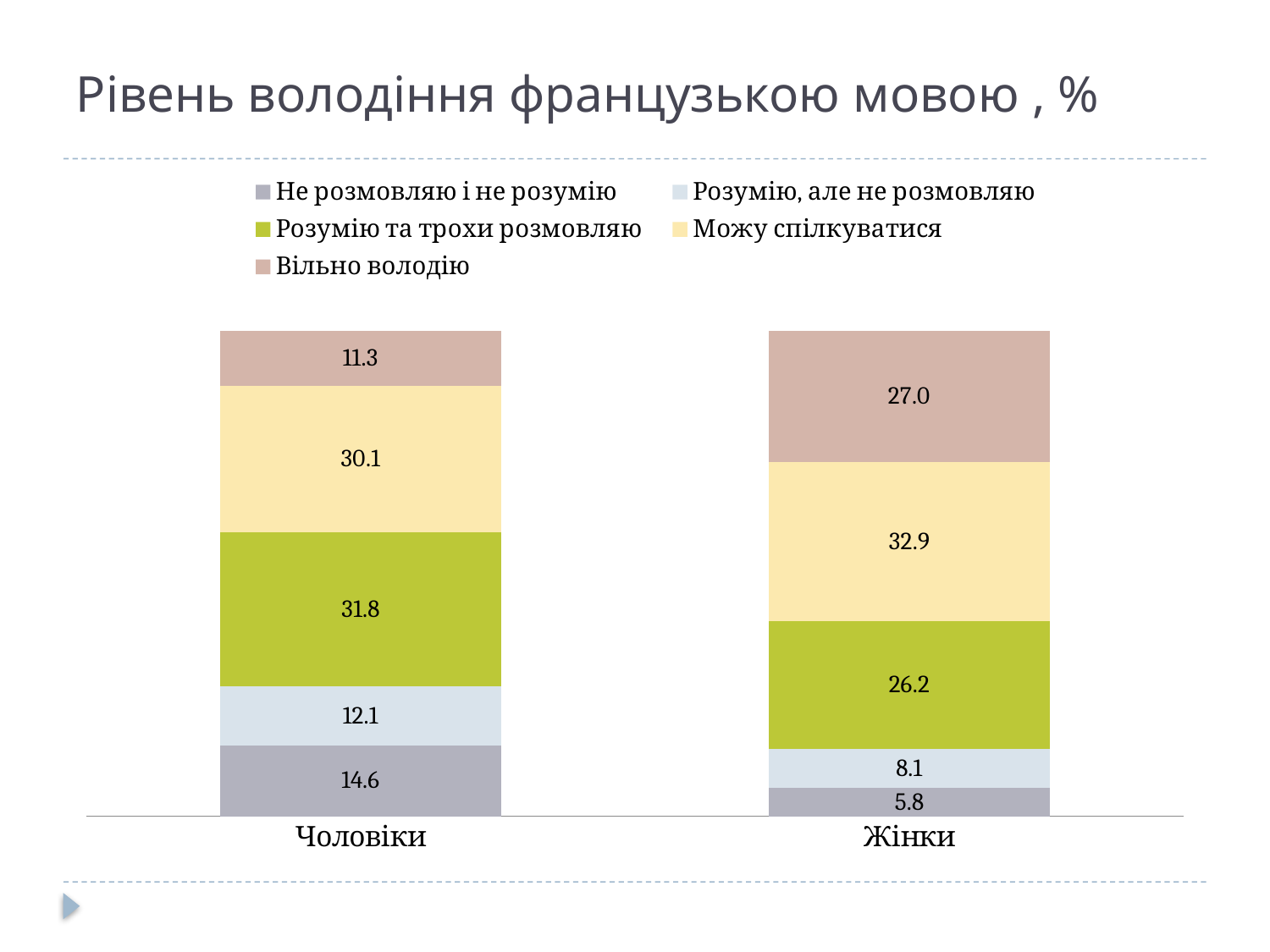
Which category has the higher value for "Вільно володію", Чоловіки or Жінки? Жінки Which segment is the smallest in the Чоловіки bar? Вільно володію What is the value for "Розумію та трохи розмовляю" for Чоловіки? 31.8 Which segment is the largest in the Жінки bar? Можу спілкуватися How many series does the legend list? 5 What is the difference between the "Розумію, але не розмовляю" values for Чоловіки and Жінки? 4.0 What is the difference between the "Вільно володію" values for Жінки and Чоловіки? 15.7 What is the value for "Вільно володію" for Чоловіки? 11.3 What is the value for "Не розмовляю і не розумію" for Жінки? 5.8 How many categories are shown on the x axis? 2 What type of chart is shown on the slide? Stacked bar chart What is the value for "Можу спілкуватися" for Жінки? 32.9